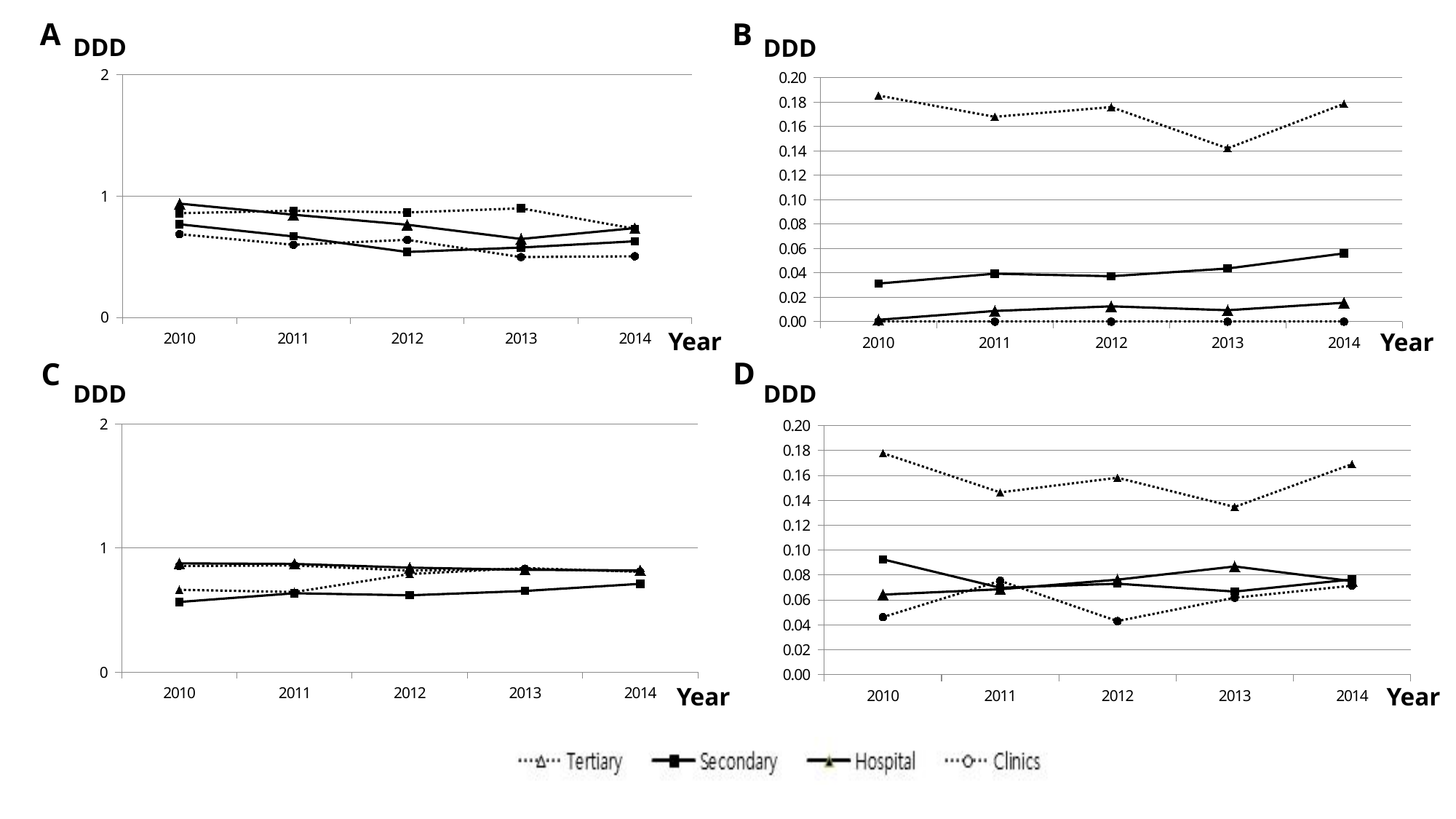
In chart B, which series has the highest values across all years? Tertiary In chart D, which is larger in 2013, the value for Hospital or the value for Secondary? Hospital In chart D, is the value for Clinics in 2012 greater or less than 0.06? less How many series does the legend at the bottom of the slide list? 4 In chart B, which series has the lowest values across all years? Clinics What kind of chart is chart A? line chart In chart B, is the value for Secondary in 2014 greater or less than 0.04? greater In chart C, does the value for Secondary rise or fall from 2010 to 2014? rise In chart A, does the value for Clinics rise or fall from 2010 to 2014? fall In chart D, which series has the lowest value in 2010? Clinics How many years are plotted along the x axis of chart B? 5 In chart B, is the value for Tertiary in 2013 greater or less than 0.16? less